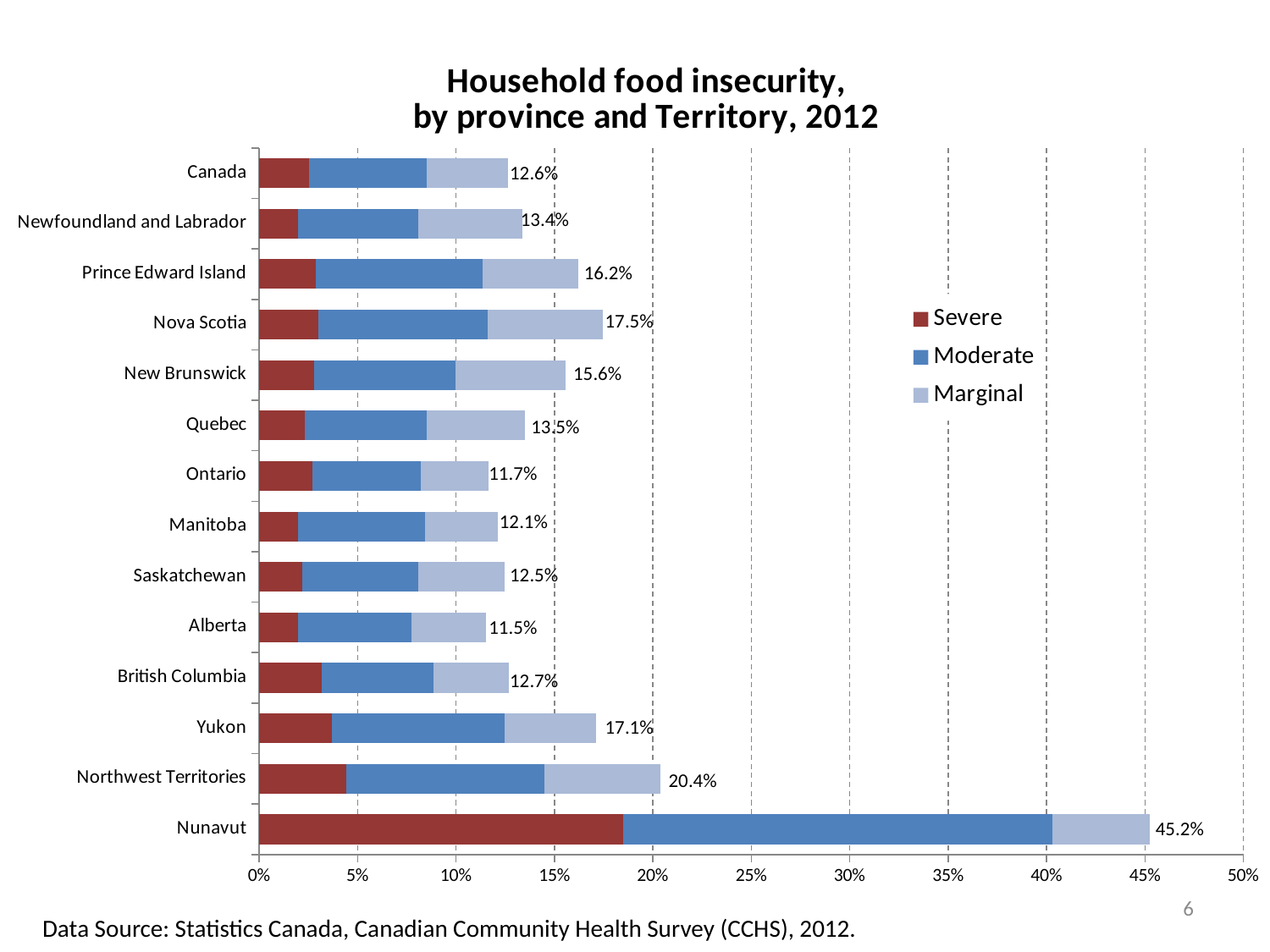
Which province or territory has the lowest total household food insecurity rate? Alberta What is the total household food insecurity rate shown for Northwest Territories? 20.4% What kind of chart is shown on the slide? Stacked bar chart What are the three series named in the legend? Severe, Moderate, Marginal What is the total household food insecurity rate shown for Nunavut? 45.2% Is the Severe segment for Nunavut greater or less than 15%? greater What is the total household food insecurity rate shown for Canada? 12.6% How many provinces, territories and national categories are plotted on the chart? 14 Which has a higher total household food insecurity rate, Prince Edward Island or New Brunswick? Prince Edward Island Which province or territory has the highest total household food insecurity rate? Nunavut How many series does the legend list? 3 What is the difference in percentage points between the total rates for Nunavut and Northwest Territories? 24.8